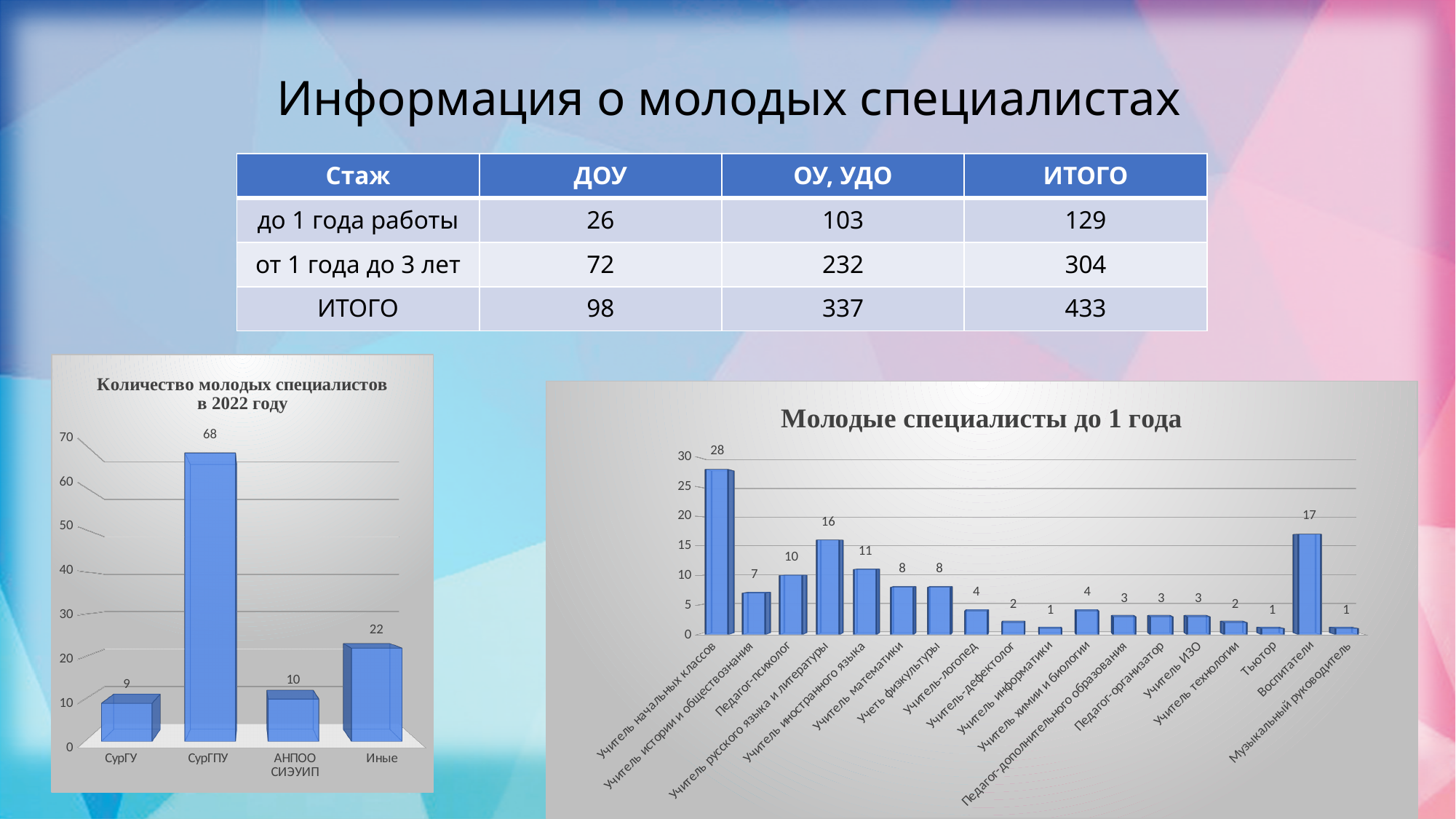
In the chart 'Молодые специалисты до 1 года', what is the value for Учитель-логопед? 4 In the chart 'Количество молодых специалистов в 2022 году', what is the difference between the values for Иные and АНПОО СИЭУИП? 12 How many categories are shown in the chart 'Молодые специалисты до 1 года'? 18 In the chart 'Количество молодых специалистов в 2022 году', what is the value for СурГПУ? 68 In the chart 'Молодые специалисты до 1 года', which category has the highest value? Учитель начальных классов In the chart 'Молодые специалисты до 1 года', what is the value for Воспитатели? 17 In the chart 'Молодые специалисты до 1 года', what is the difference between the values for Учитель начальных классов and Воспитатели? 11 How many categories are shown in the chart 'Количество молодых специалистов в 2022 году'? 4 In the chart 'Количество молодых специалистов в 2022 году', which category has the lowest value? СурГУ What kind of chart is 'Количество молодых специалистов в 2022 году'? Bar chart In the chart 'Молодые специалисты до 1 года', which is larger: the value for Педагог-психолог or the value for Учитель иностранного языка? Учитель иностранного языка In the chart 'Молодые специалисты до 1 года', what is the value for Учитель русского языка и литературы? 16